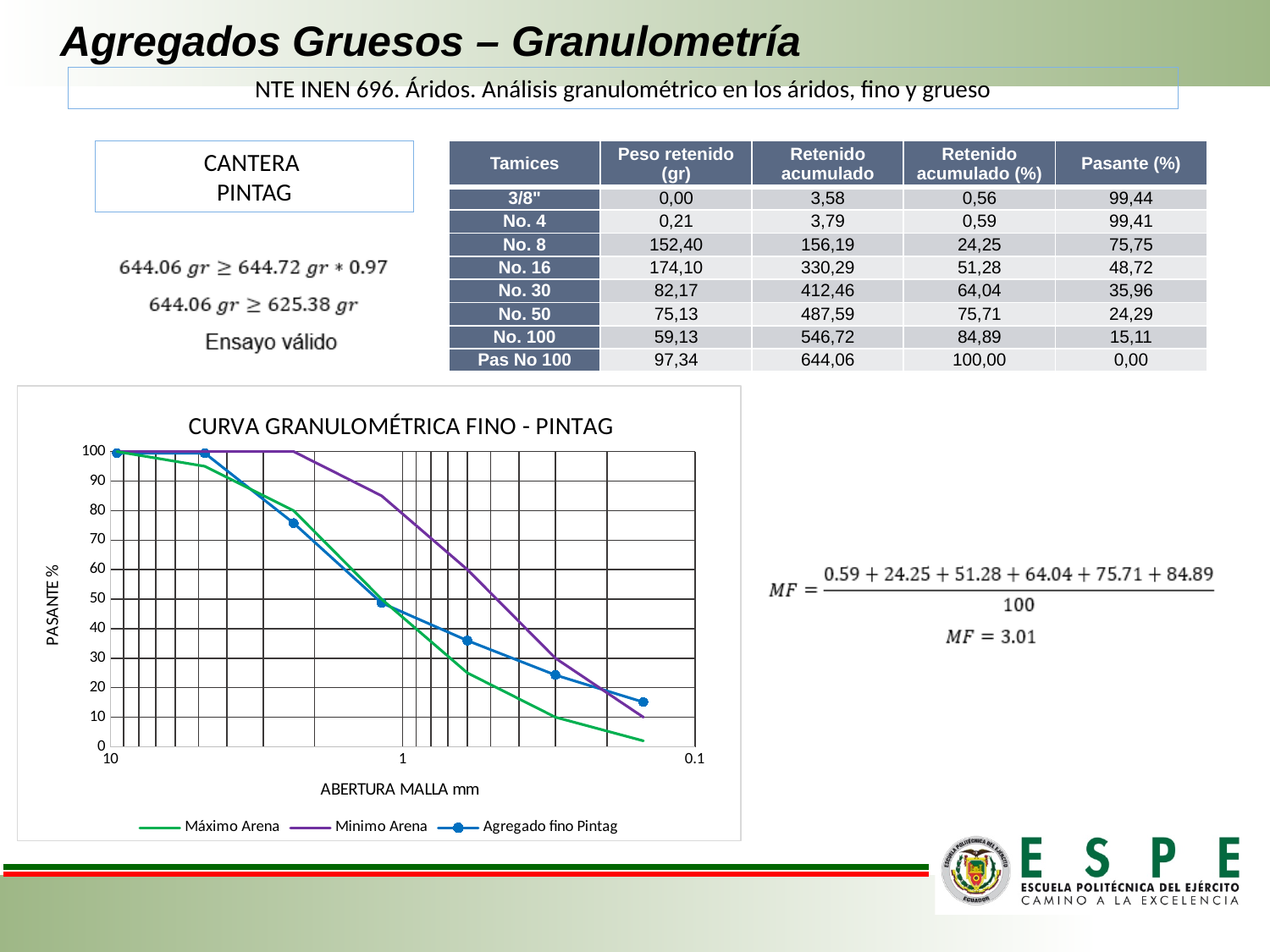
What is the highest tick value shown on the y axis (PASANTE %)? 100 What is the label of the x axis of the chart? ABERTURA MALLA mm How many series does the chart legend list? 3 Is the value of the leftmost point of the Agregado fino Pintag series greater or less than 90? greater What is the title of the chart? CURVA GRANULOMÉTRICA FINO - PINTAG Which series has the highest value at 1 mm on the x axis? Minimo Arena Does the Agregado fino Pintag series rise or fall moving from left to right along the x axis? fall What type of chart is shown on the slide? line chart Is the value of the Agregado fino Pintag series at the point nearest 1 mm on the x axis greater or less than 60? less How many data points are marked on the Agregado fino Pintag series? 7 At 1 mm on the x axis, which series is higher, Máximo Arena or Minimo Arena? Minimo Arena Is the value of the rightmost point of the Agregado fino Pintag series greater or less than 20? less